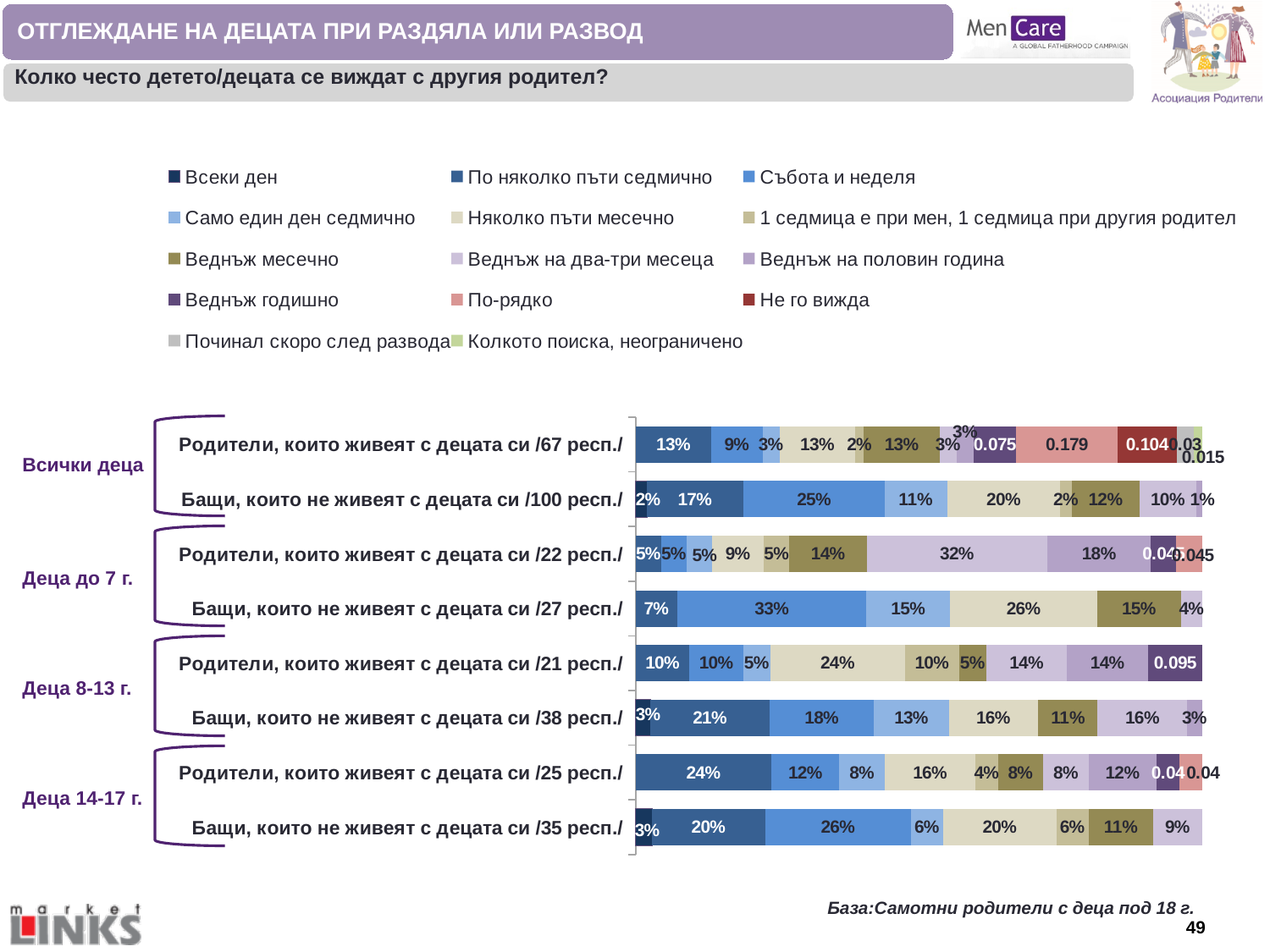
What is the largest segment value in the bar for 'Бащи, които не живеят с децата си /27 респ./'? 33% How many age groups are the bars organised into on the left side of the chart? 4 What question does the chart answer, according to the subtitle above it? Колко често детето/децата се виждат с другия родител? How many series does the legend list? 14 What is the largest segment value in the bar for 'Бащи, които не живеят с децата си /35 респ./'? 26% What is the largest segment value in the bar for 'Родители, които живеят с децата си /22 респ./'? 32% What is the value of 'Всеки ден' for 'Бащи, които не живеят с децата си /100 респ./'? 2% What kind of chart is shown on the slide? Stacked bar chart How many bars (respondent groups) are plotted in the chart? 8